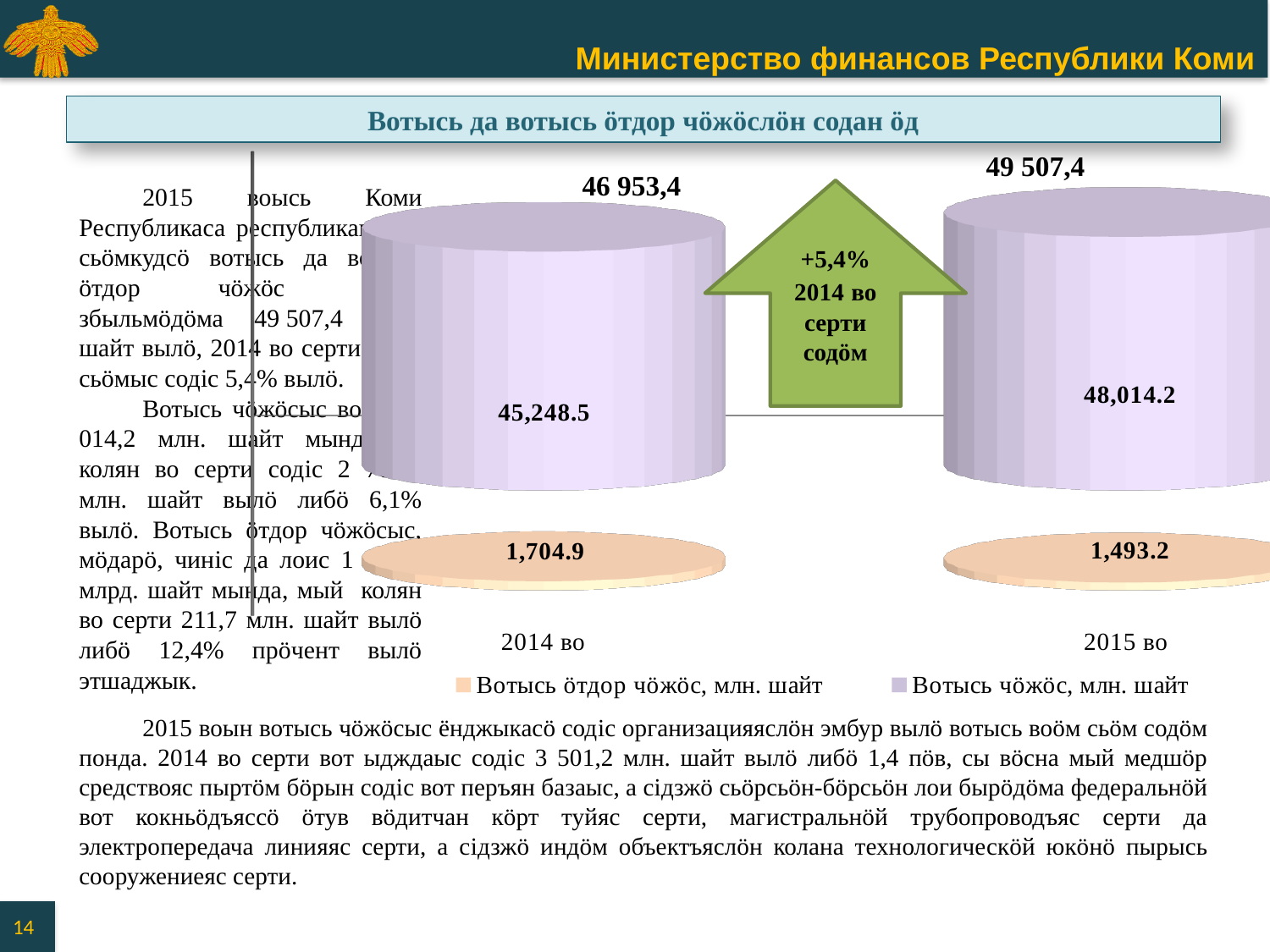
What is the difference between the Вотысь чöжöс, млн. шайт values for 2015 во and 2014 во? 2,765.7 Which year has the lower value for Вотысь öтдор чöжöс, млн. шайт? 2015 во What is the value of Вотысь öтдор чöжöс, млн. шайт for 2015 во? 1,493.2 What is the total shown above the stacked bar for 2015 во? 49 507,4 How many categories are shown on the x axis? 2 What is the value of Вотысь öтдор чöжöс, млн. шайт for 2014 во? 1,704.9 How many series does the legend list? 2 What is the total shown above the stacked bar for 2014 во? 46 953,4 Which year has the higher value for Вотысь чöжöс, млн. шайт, 2014 во or 2015 во? 2015 во What is the value of Вотысь чöжöс, млн. шайт for 2015 во? 48,014.2 What is the value of Вотысь чöжöс, млн. шайт for 2014 во? 45,248.5 What percentage change is shown in the green arrow between the two bars? +5,4%